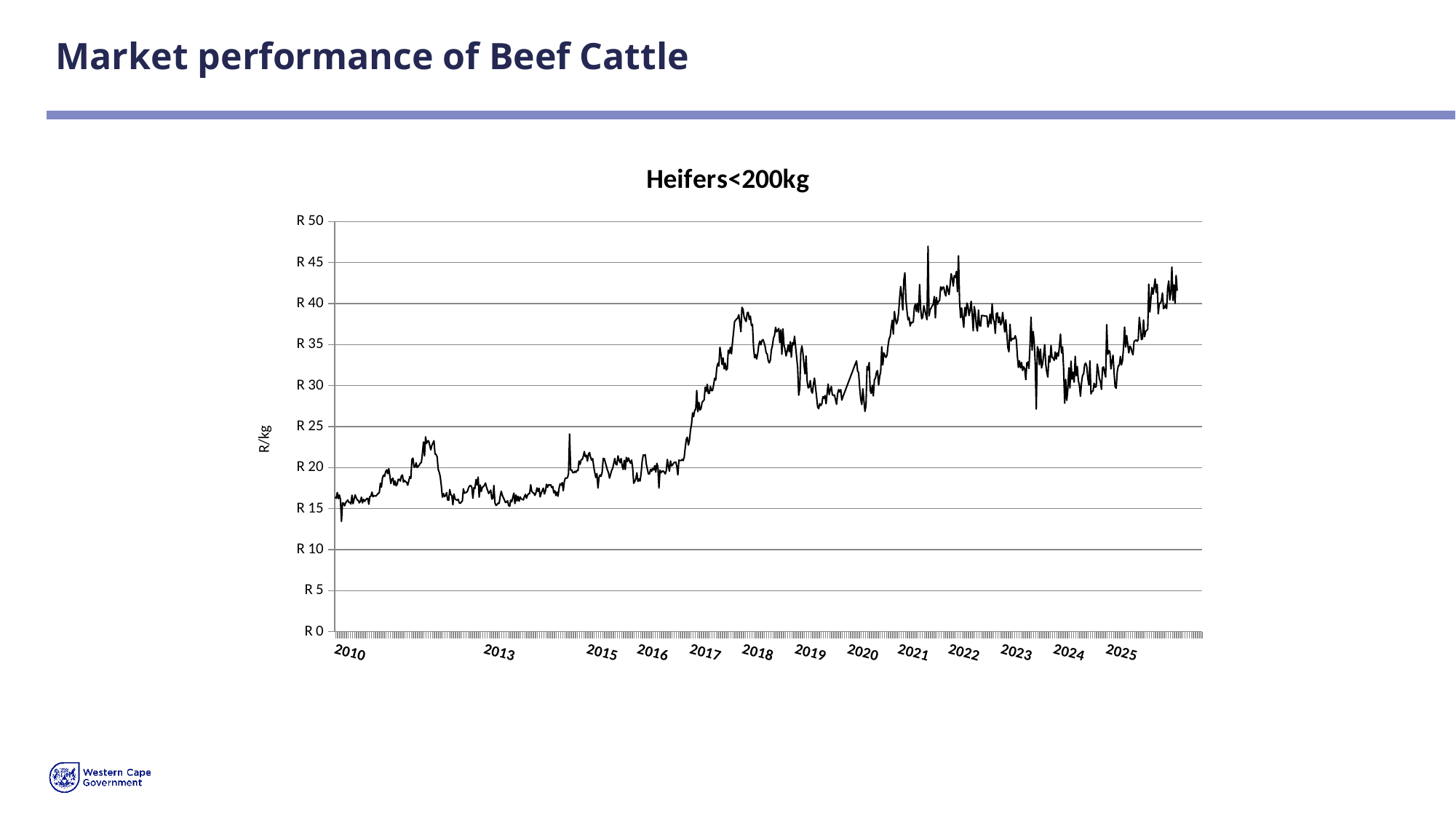
Is the value around 2018 greater or less than R 30? greater Is the value around 2020 greater or less than R 25? greater Overall, do the values rise or fall from 2010 to 2025? Rise Is the value around 2021 greater or less than R 35? greater What is the label on the vertical axis of the chart? R/kg What is the title of the chart? Heifers<200kg What kind of chart is shown on the slide? Line chart Which is larger, the value around 2013 or the value around 2018? 2018